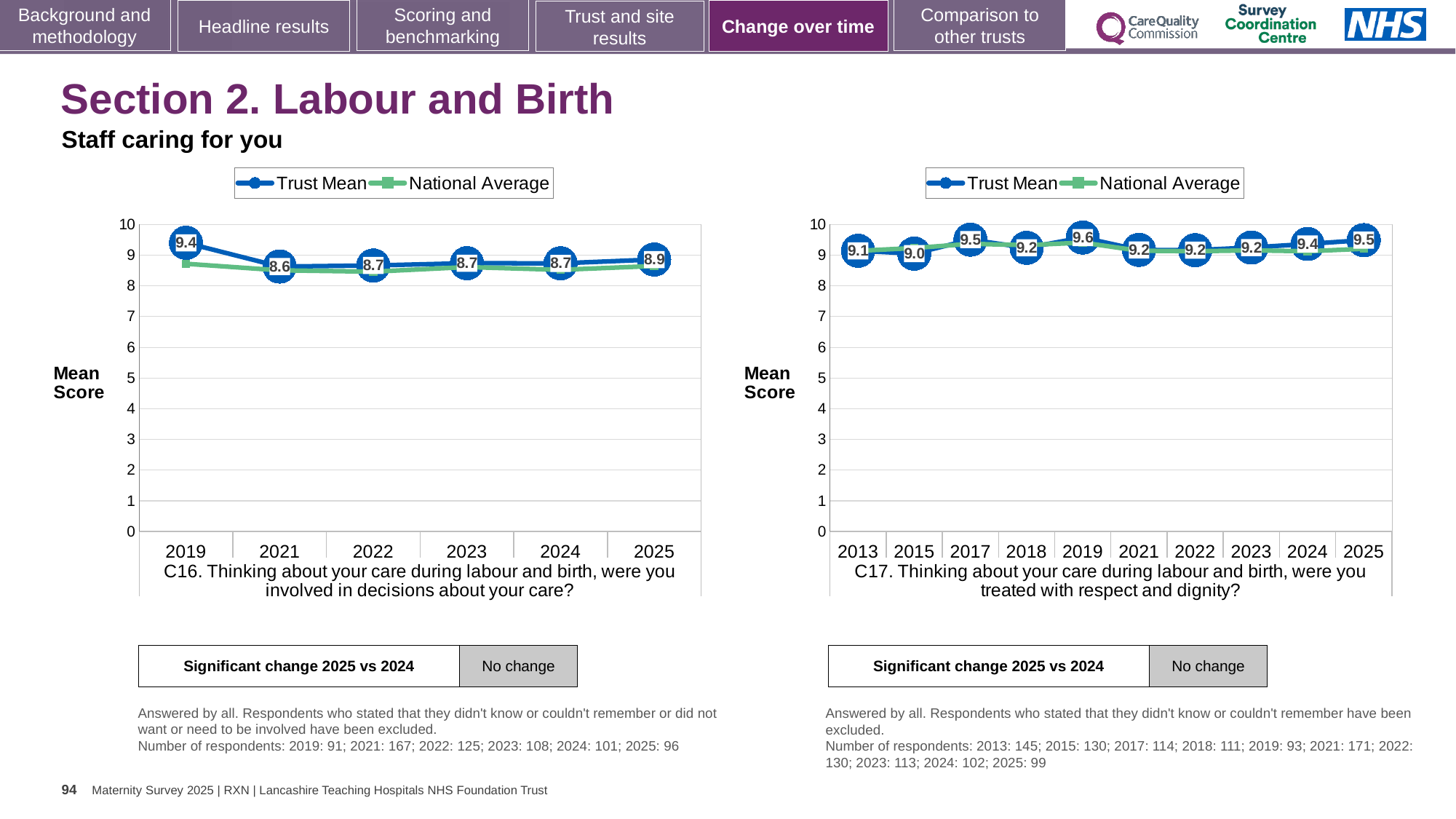
On the C16 chart (left), which year has the highest Trust Mean? 2019 On the C17 chart (right), is the Trust Mean for 2025 larger or smaller than the Trust Mean for 2024? larger On the C16 chart (left), which year has the lowest Trust Mean? 2021 On the C17 chart (right), what is the Trust Mean for 2019? 9.6 On the C16 chart (left), what is the Trust Mean for 2019? 9.4 How many series does the legend of the C16 chart (left) list? 2 On the C17 chart (right), what is the Trust Mean for 2013? 9.1 On the C16 chart (left), what is the Trust Mean for 2025? 8.9 On the C16 chart (left), what is the difference between the Trust Mean in 2019 and in 2021? 0.8 On the C17 chart (right), how many years are plotted on the x axis? 10 On the C16 chart (left), how many years are plotted on the x axis? 6 On the C17 chart (right), which year has the highest Trust Mean? 2019